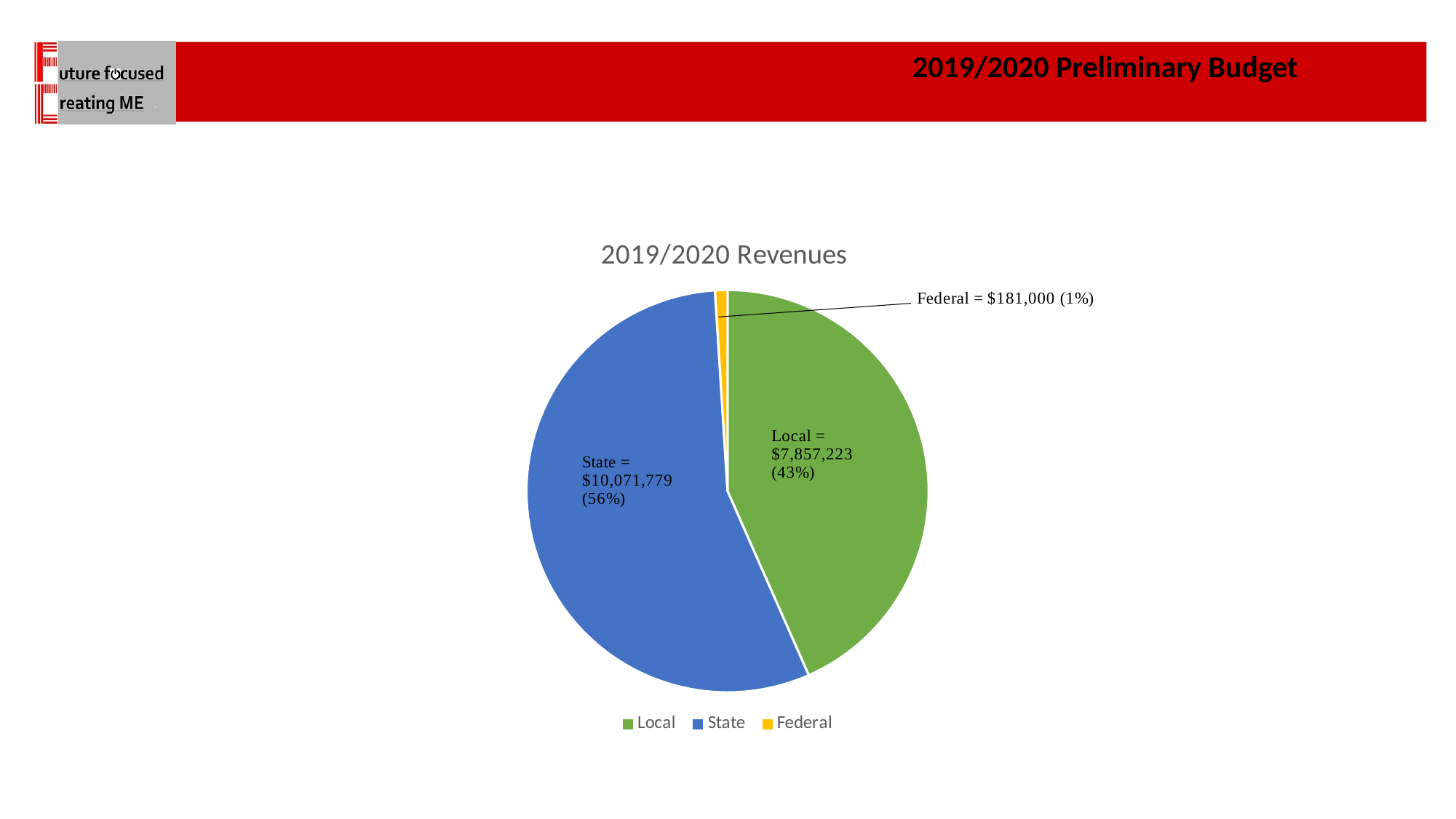
What is the revenue value for Federal? $181,000 What is the revenue value for Local? $7,857,223 What type of chart is shown on the slide? pie chart What is the revenue value for State? $10,071,779 What percentage share of revenues does State represent? 56% Which is larger, the Local revenue or the Federal revenue? Local Which revenue source has the smallest share? Federal How many series does the legend list? 3 What is the difference between the State and Local revenue values? $2,214,556 Which revenue source has the largest share? State What percentage share of revenues does Local represent? 43% What is the title of the chart? 2019/2020 Revenues